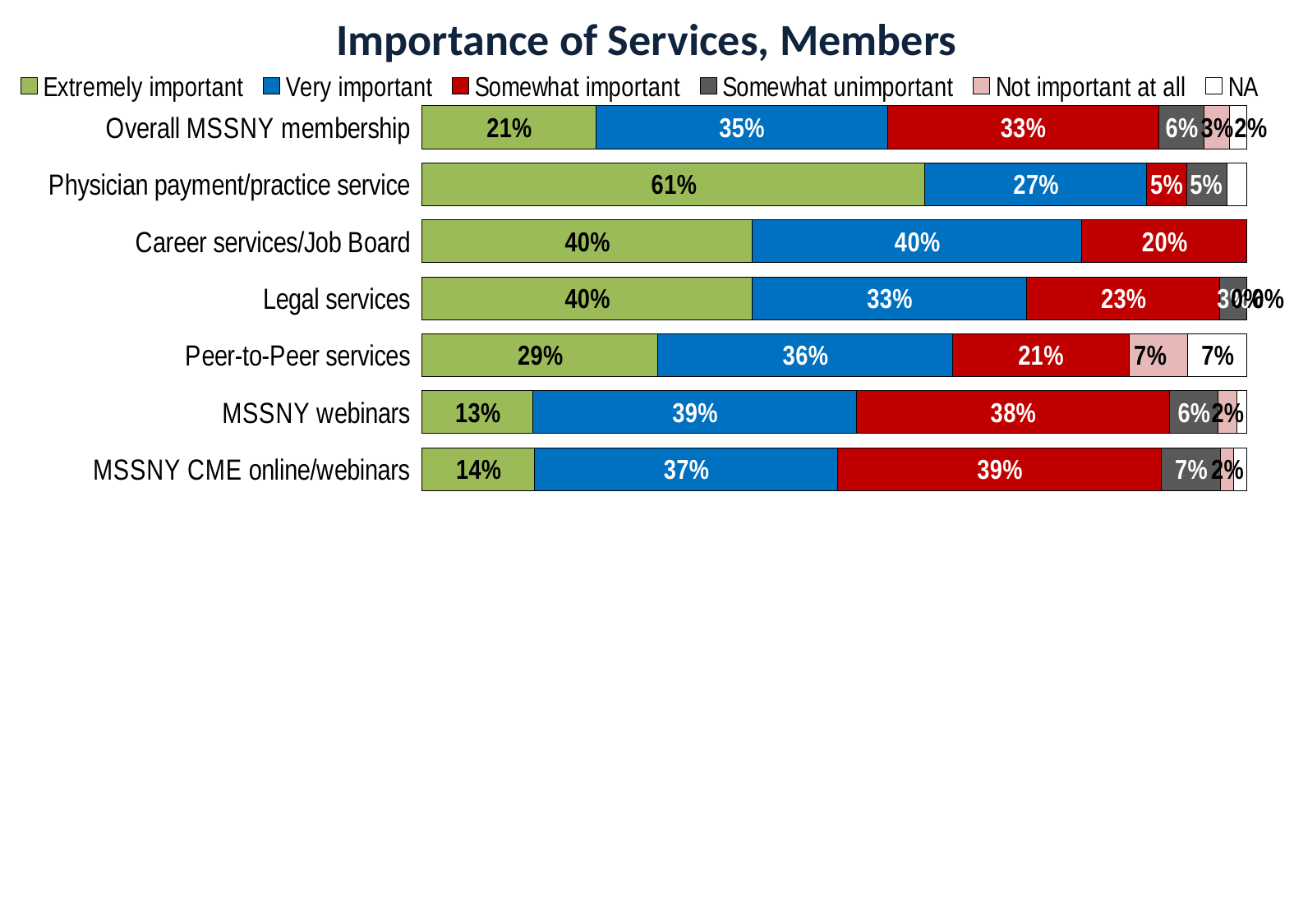
What type of chart is shown on the slide? Stacked bar chart Which service has the lowest Extremely important percentage? MSSNY webinars What is the difference between the Extremely important values for Physician payment/practice service and Overall MSSNY membership? 40% How many service categories are shown in the chart? 7 What is the Somewhat important value for MSSNY CME online/webinars? 39% How many series does the legend list? 6 Which service has the highest Extremely important percentage? Physician payment/practice service What percentage of members rated Physician payment/practice service as Extremely important? 61% What is the Not important at all value for Peer-to-Peer services? 7% What is the title of the chart? Importance of Services, Members Which is larger: the Very important value for MSSNY webinars or for Peer-to-Peer services? MSSNY webinars What is the Very important value for Career services/Job Board? 40%